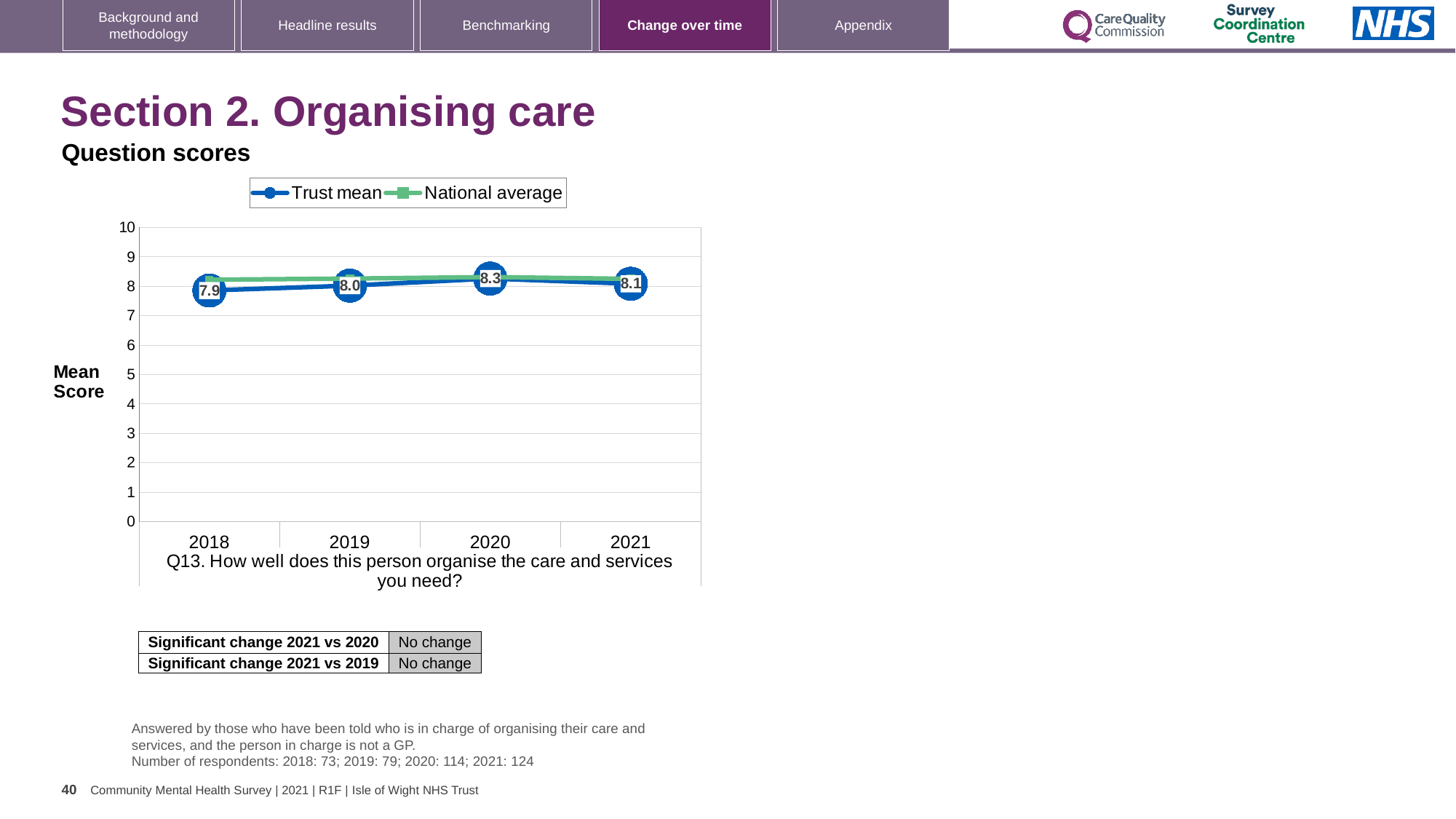
How many series does the chart legend list? 2 What is the difference between the Trust mean score in 2020 and in 2018? 0.4 Which year has the larger Trust mean score, 2019 or 2021? 2021 How many years are plotted on the x axis of the chart? 4 What is the Trust mean score for 2021? 8.1 In which year is the Trust mean score highest? 2020 What is the Trust mean score for 2018? 7.9 Is the National average value for 2020 greater or less than 7? greater What kind of chart is shown on the slide? Line chart What is the Trust mean score for 2020? 8.3 Does the Trust mean score rise or fall from 2018 to 2020? Rise In which year is the Trust mean score lowest? 2018